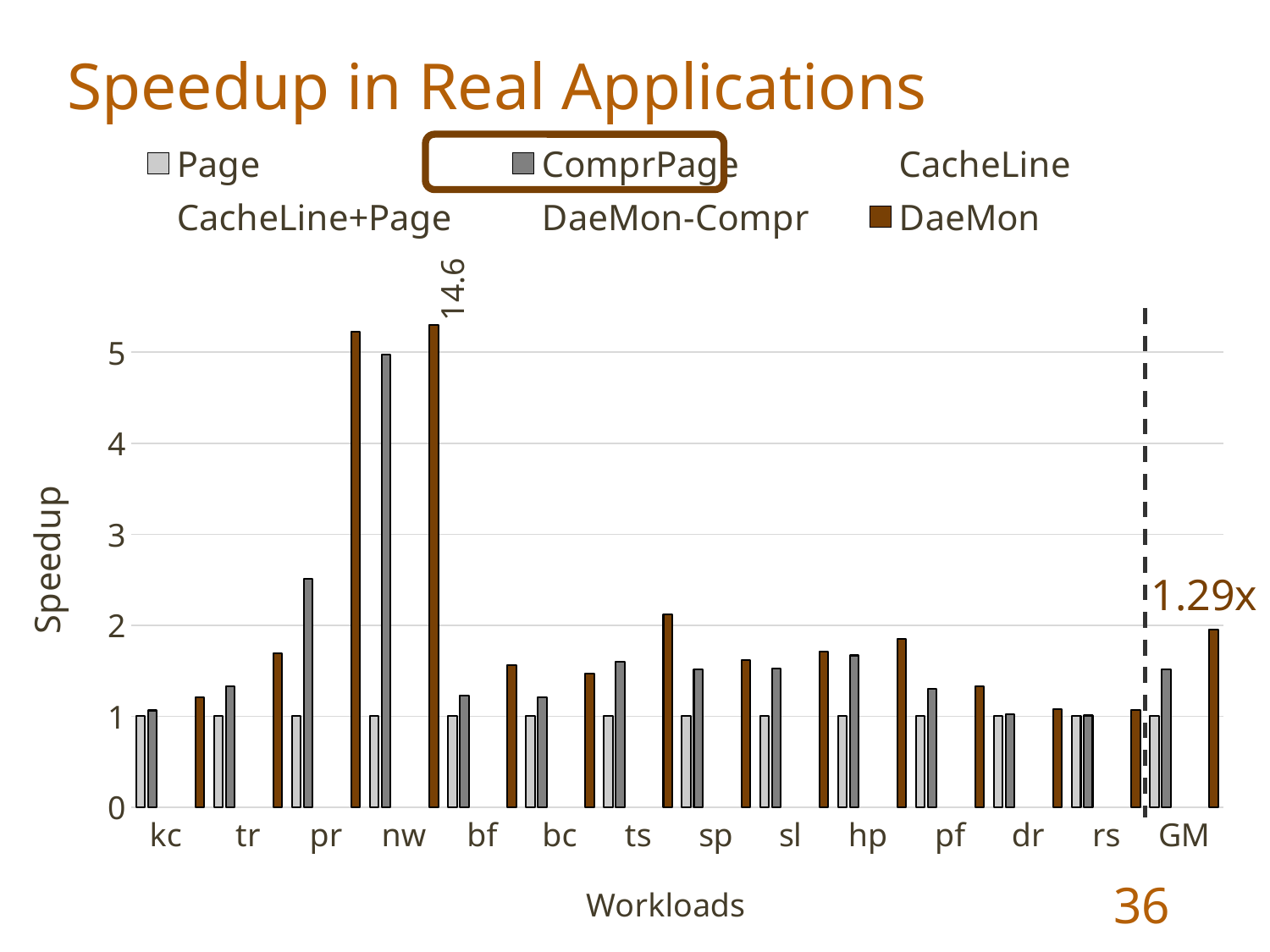
Which workload has the highest ComprPage speedup? nw How many workloads are shown along the x axis? 14 How many series does the legend list? 6 What value is printed above the DaeMon bar for nw? 14.6 Is the DaeMon value for hp greater or less than 2? less What kind of chart is shown on the slide? bar chart What is the title of the y axis? Speedup What is the title of the chart? Speedup in Real Applications For ts, which is larger: the DaeMon bar or the ComprPage bar? DaeMon Which workload has the highest DaeMon speedup? nw Is the ComprPage value for pr greater or less than 2? greater